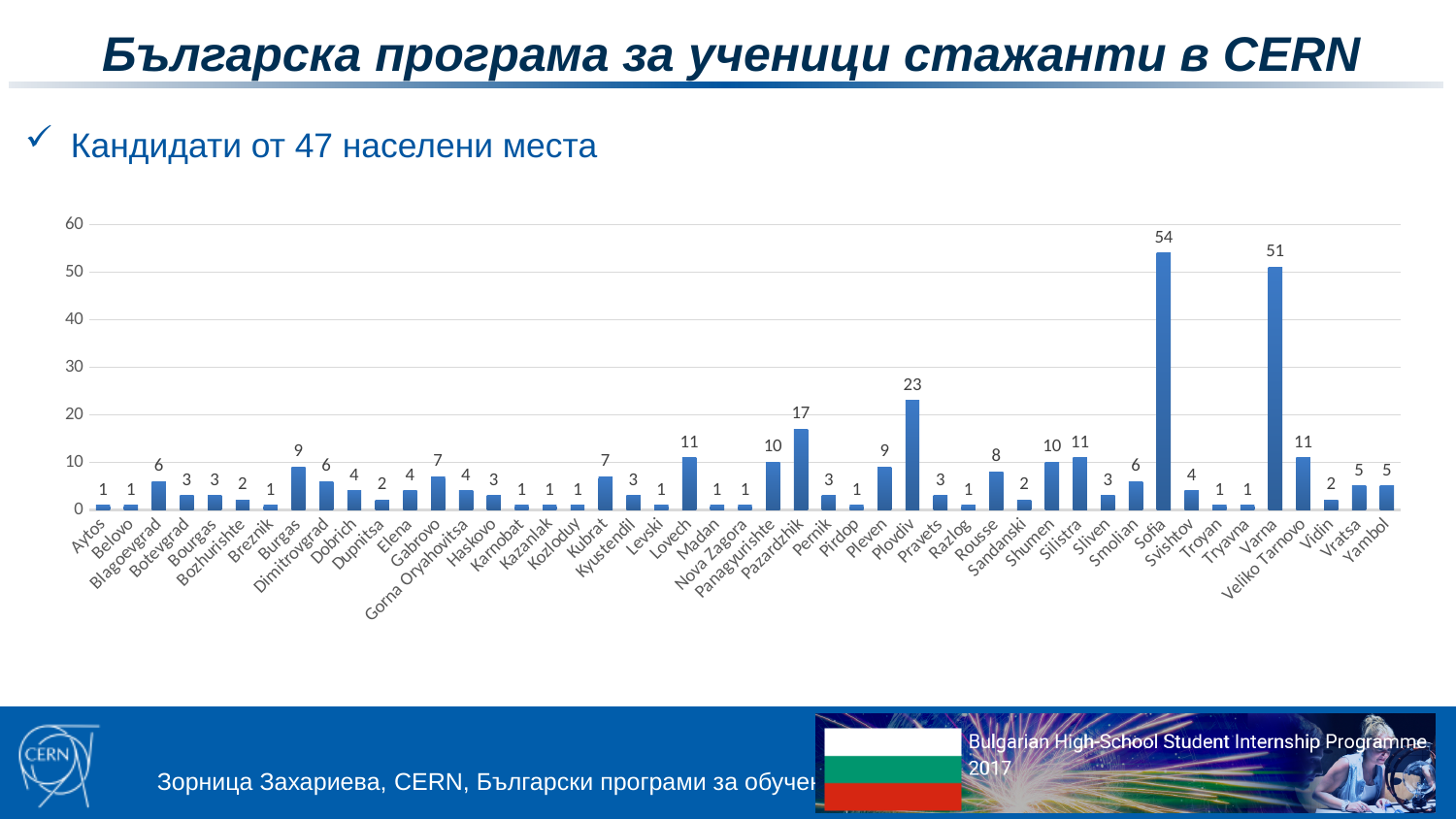
What is the value for Sofia? 54 What is the value for Pazardzhik? 17 What is the difference between the values for Plovdiv and Pazardzhik? 6 Which category has the highest value? Sofia What is the difference between the values for Sofia and Varna? 3 Which is larger, the value for Lovech or the value for Pleven? Lovech What kind of chart is shown on the slide? bar chart What is the value for Gabrovo? 7 What is the value for Plovdiv? 23 How many categories are shown on the x axis? 47 Is the value for Varna greater or less than 40? greater What is the highest tick value shown on the y axis? 60